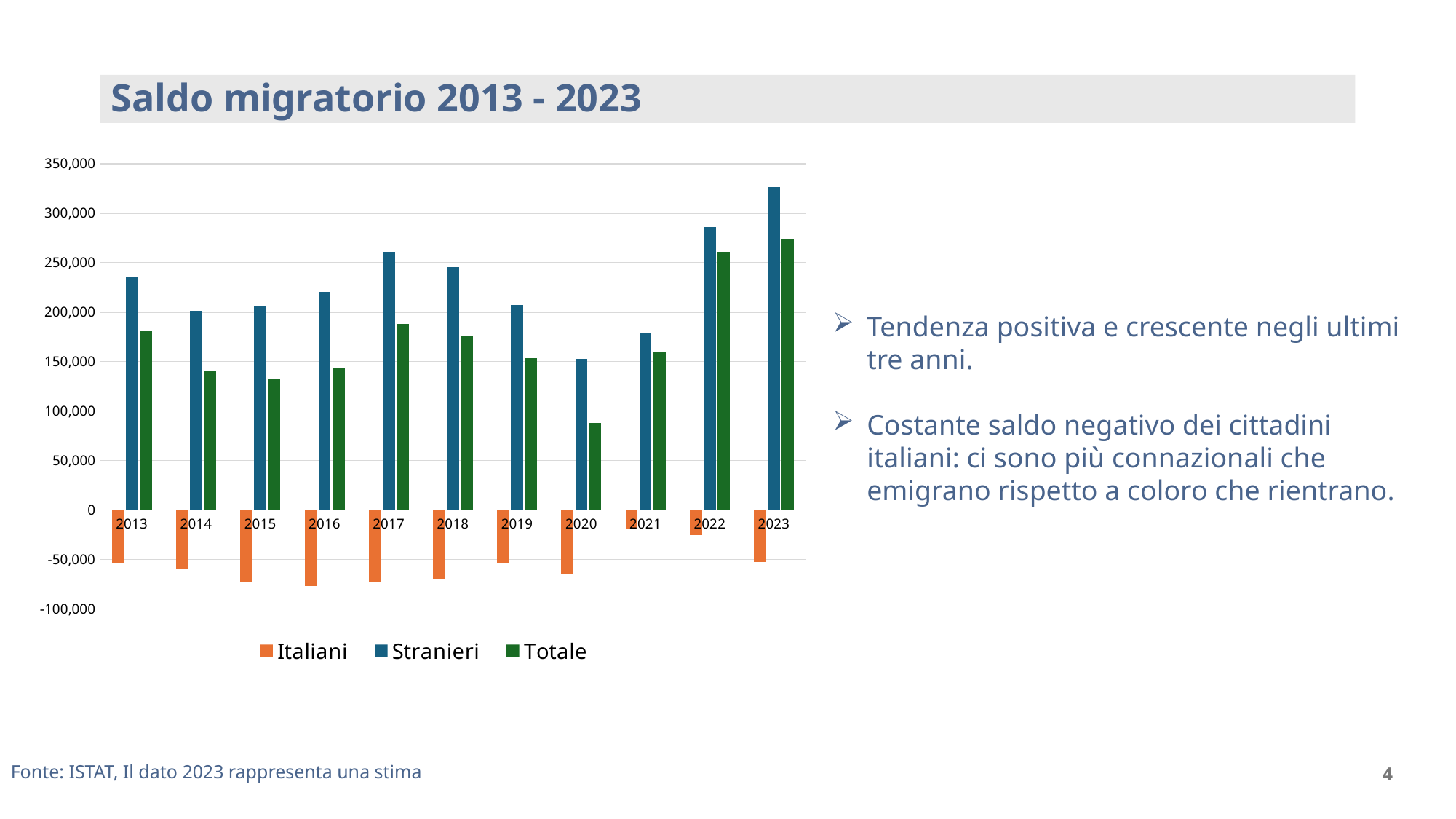
In which year is the Totale value lowest? 2020 What is the title of the chart? Saldo migratorio 2013 - 2023 What kind of chart is shown on the slide? bar chart Which is larger, the Stranieri value for 2022 or for 2017? 2022 How many years are shown on the x axis? 11 How many series does the legend list? 3 In which year is the Stranieri value lowest? 2020 Does the Totale value rise or fall from 2020 to 2023? rise In which year is the Italiani value highest (least negative)? 2021 Is the Stranieri value for 2023 greater or less than 300,000? greater In which year is the Stranieri value highest? 2023 Is the Totale value for 2020 greater or less than 100,000? less